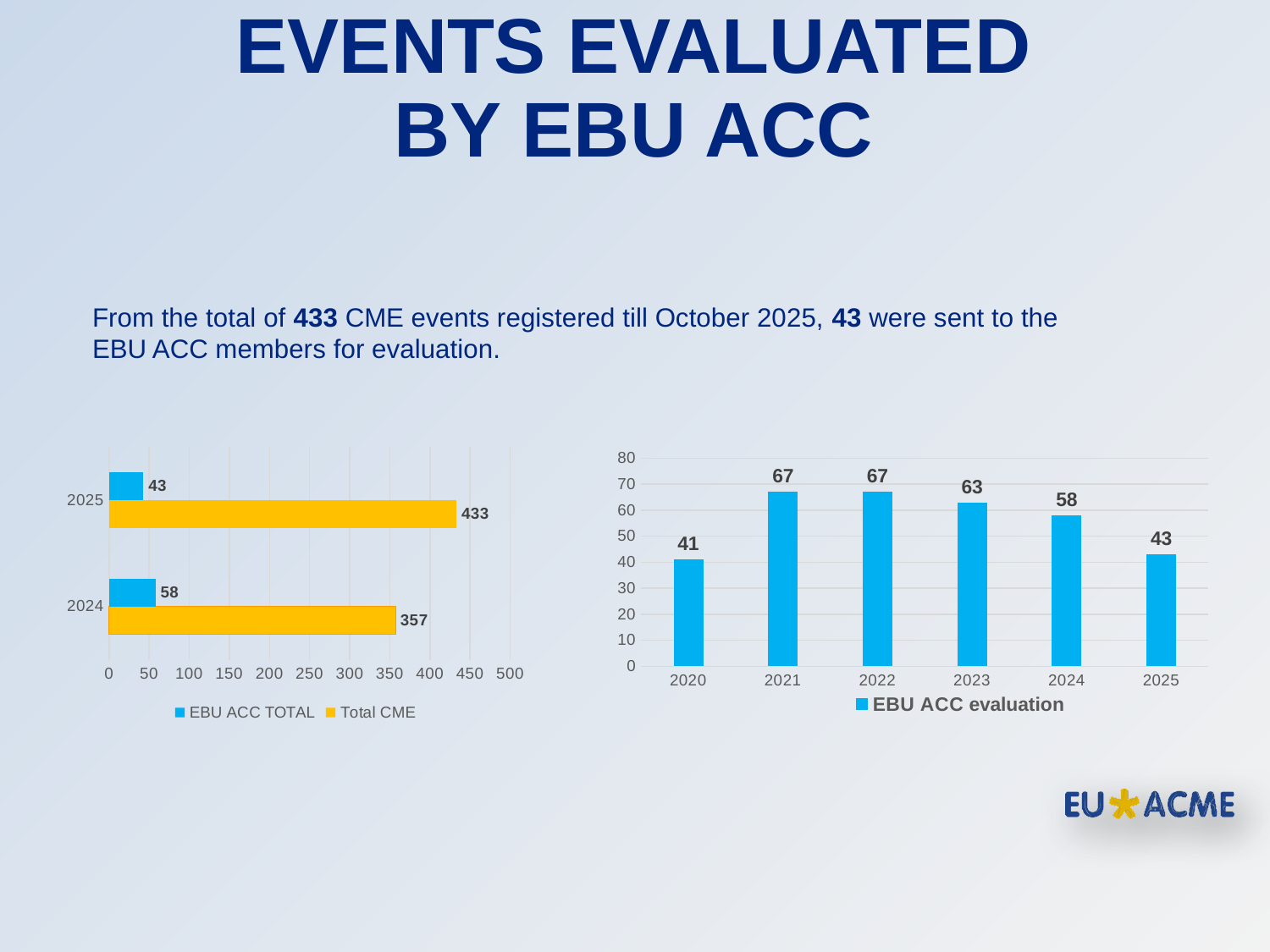
In the right chart, what is the EBU ACC evaluation value for 2020? 41 In the left chart, what is the Total CME value for 2025? 433 In the right chart, what is the difference between the values for 2023 and 2025? 20 In the left chart, what is the difference between the Total CME values for 2025 and 2024? 76 In the right chart, which year has the lowest EBU ACC evaluation value? 2020 In the right chart, is the value for 2024 larger or smaller than the value for 2022? smaller In the left chart, how many series does the legend list? 2 What kind of chart is the right chart? bar chart In the right chart, do the values rise or fall from 2022 to 2025? fall In the left chart, what is the EBU ACC TOTAL value for 2024? 58 In the left chart, which series is shown in yellow? Total CME In the right chart, how many years are shown on the x axis? 6